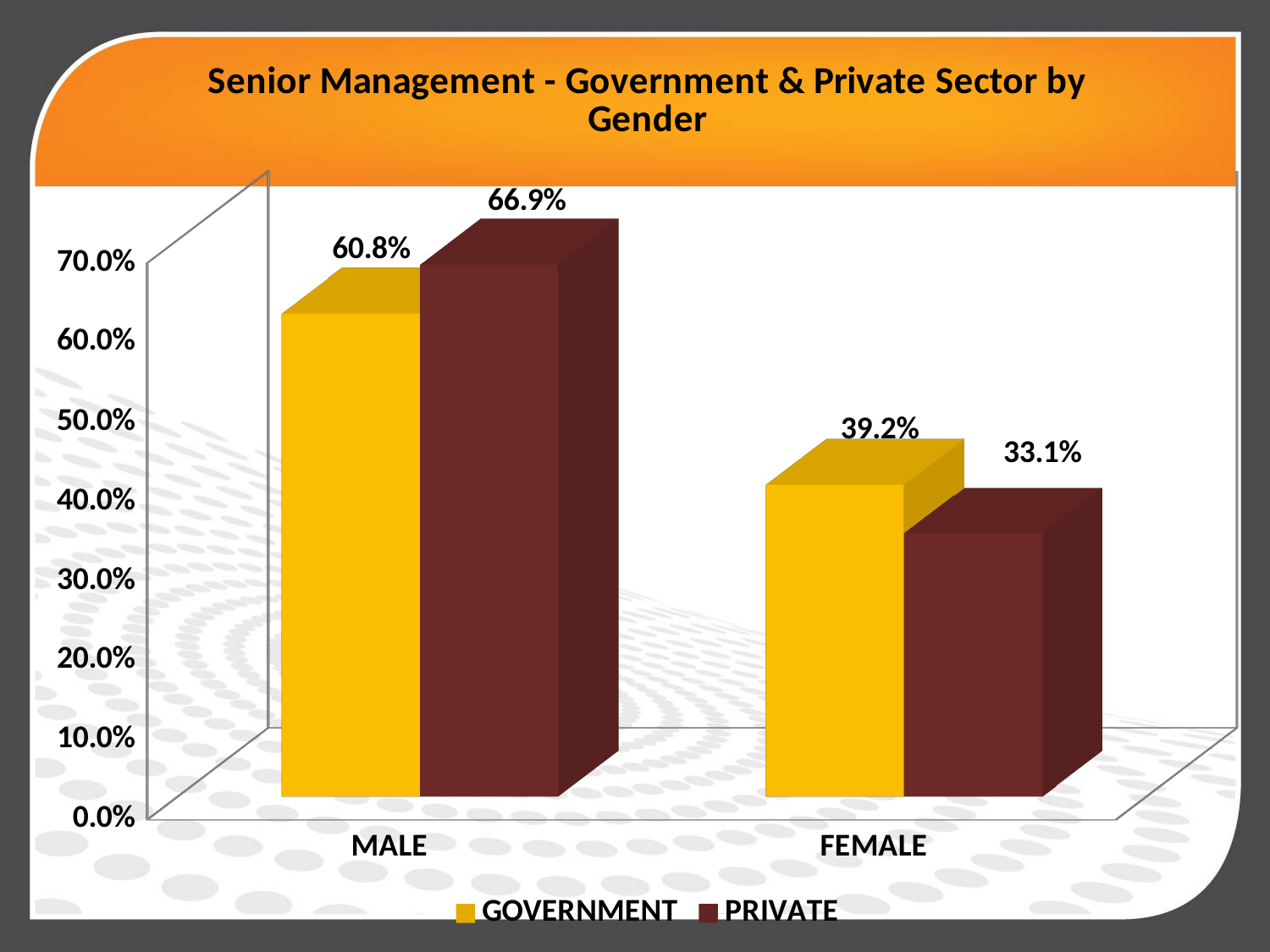
How many series does the legend list? 2 Which category has the highest PRIVATE value? MALE What is the GOVERNMENT value for MALE? 60.8% What is the difference between the GOVERNMENT and PRIVATE values for FEMALE? 6.1% How many categories are shown on the x axis? 2 Which category has the lowest GOVERNMENT value? FEMALE For FEMALE, which is larger: GOVERNMENT or PRIVATE? GOVERNMENT What is the difference between the PRIVATE and GOVERNMENT values for MALE? 6.1% Is the PRIVATE value for MALE greater or less than 60.0%? greater What is the GOVERNMENT value for FEMALE? 39.2% What kind of chart is shown on the slide? bar chart What is the PRIVATE value for FEMALE? 33.1%